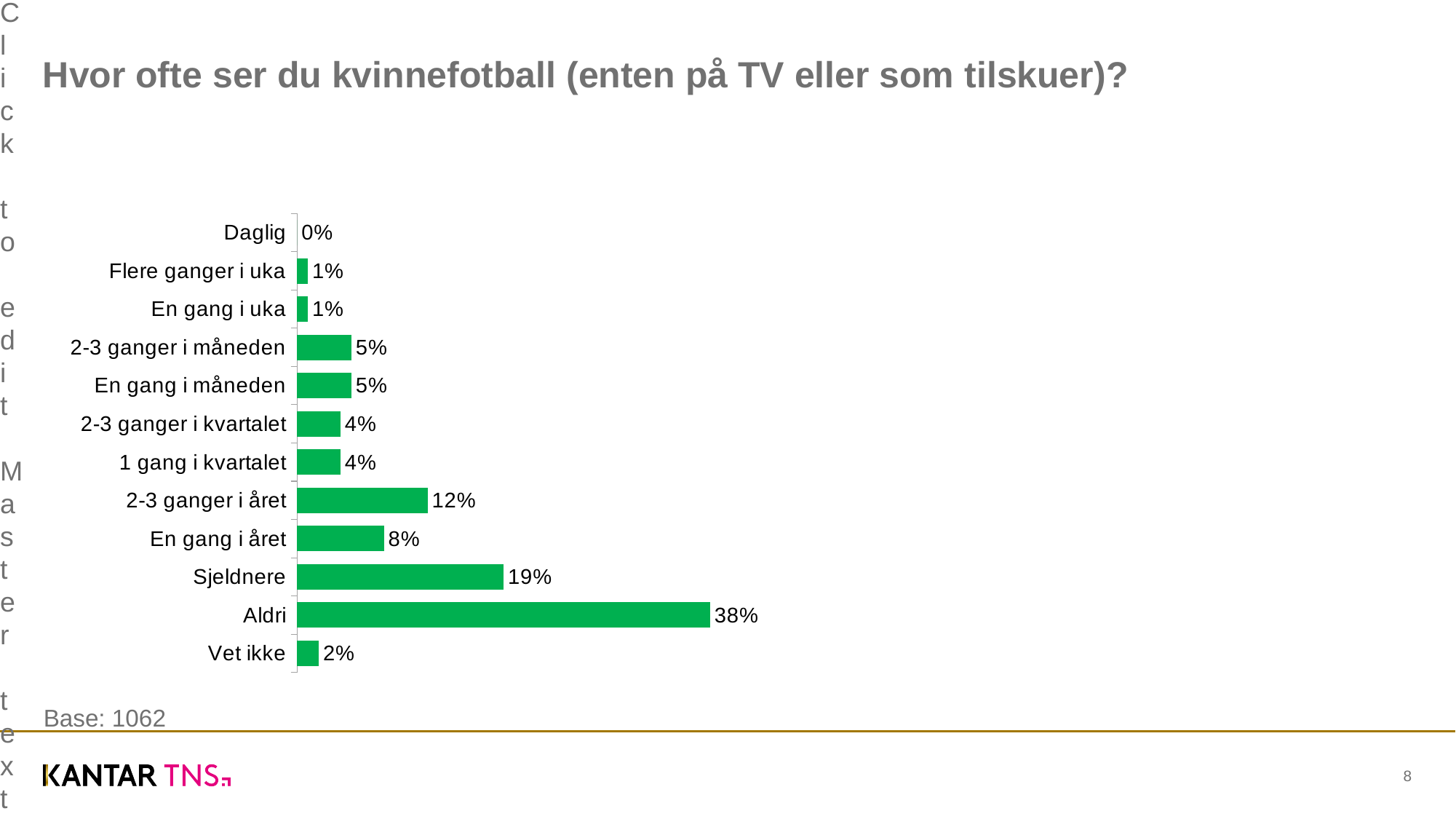
What is the difference between the values for 2-3 ganger i året and En gang i året? 4% What is the value for Aldri? 38% What is the difference between the values for Aldri and Sjeldnere? 19% How many categories are shown in the chart? 12 Which is larger, the value for Sjeldnere or the value for En gang i året? Sjeldnere Which category has the lowest value? Daglig What is the value for 2-3 ganger i året? 12% What kind of chart is shown on the slide? Bar chart Which category has the highest value? Aldri What is the value for Vet ikke? 2% What is the title of the slide? Hvor ofte ser du kvinnefotball (enten på TV eller som tilskuer)? What is the value for Sjeldnere? 19%